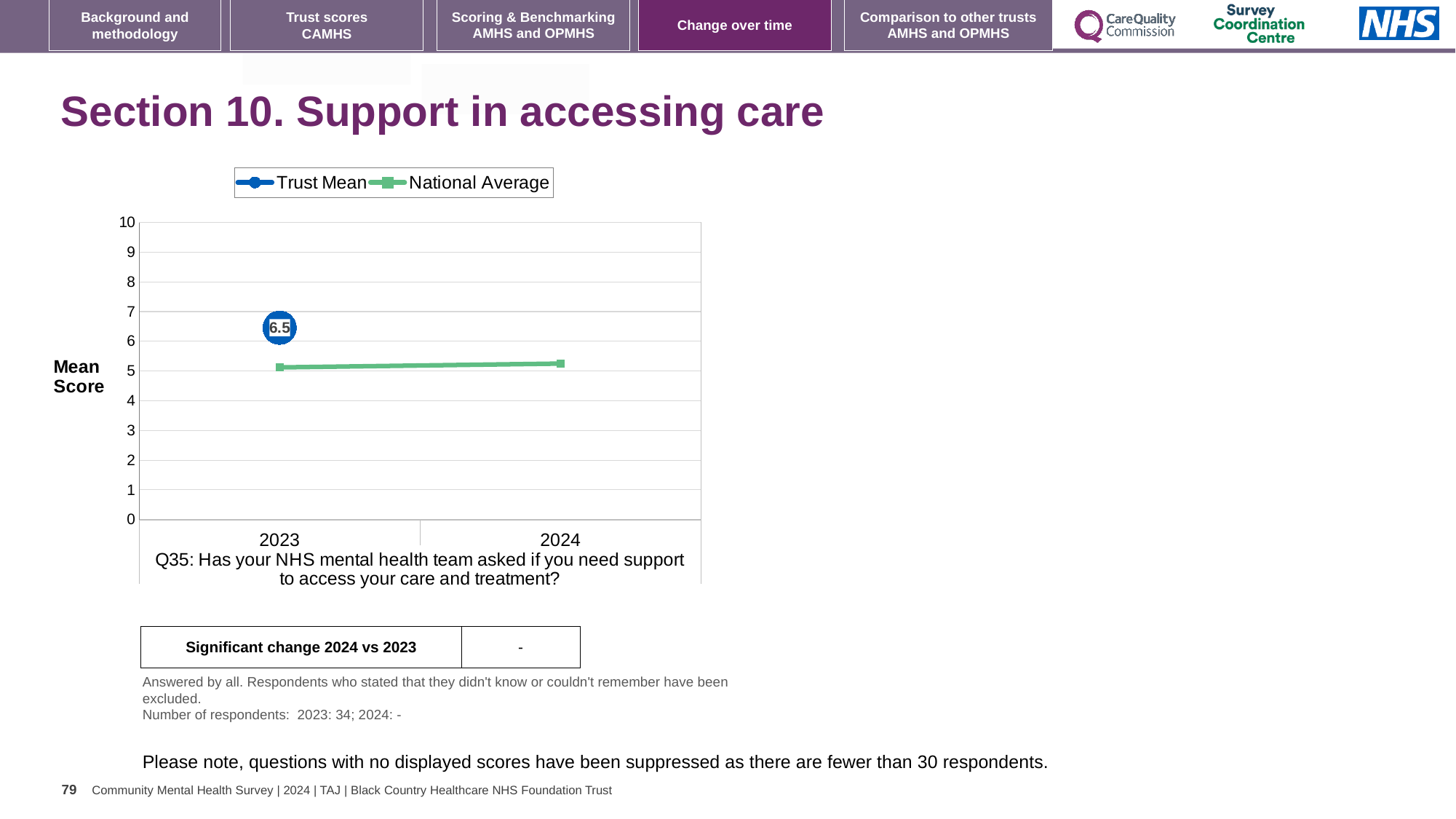
How many years are shown on the x axis? 2 Does the National Average rise or fall from 2023 to 2024? rise Is the National Average value for 2023 greater or less than 6? less Is the National Average value for 2024 greater or less than 6? less Which is larger in 2023, the Trust Mean or the National Average? Trust Mean Is the Trust Mean value for 2023 greater or less than 6? greater Which series is shown in green in the legend? National Average What kind of chart is shown on the slide? line chart What is the Trust Mean value for 2023? 6.5 What is the label on the y axis of the chart? Mean Score How many series does the legend list? 2